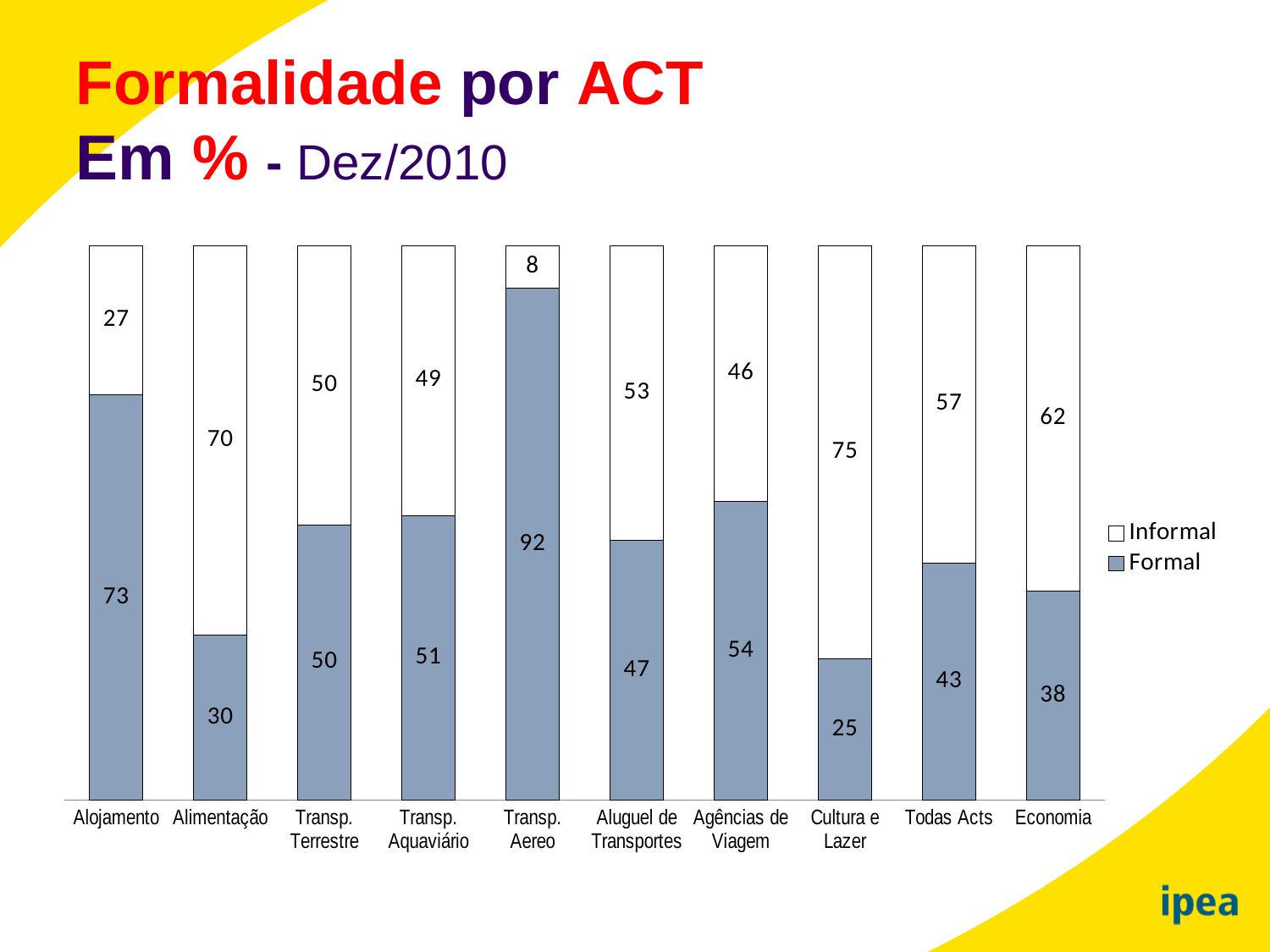
What is the difference between the Formal values for Alojamento and Alimentação? 43 Which is larger, the Formal value for Agências de Viagem or the Formal value for Aluguel de Transportes? Agências de Viagem What kind of chart is shown on the slide? Stacked bar chart What is the total of the stacked bar for Todas Acts? 100 What is the Informal value for Cultura e Lazer? 75 What is the Formal value for Transp. Aereo? 92 Which category has the lowest Formal value? Cultura e Lazer Which series is shown in the blue-grey colour? Formal How many series does the legend list? 2 What is the Formal value for Economia? 38 How many categories are shown on the x axis? 10 Which category has the highest Formal value? Transp. Aereo